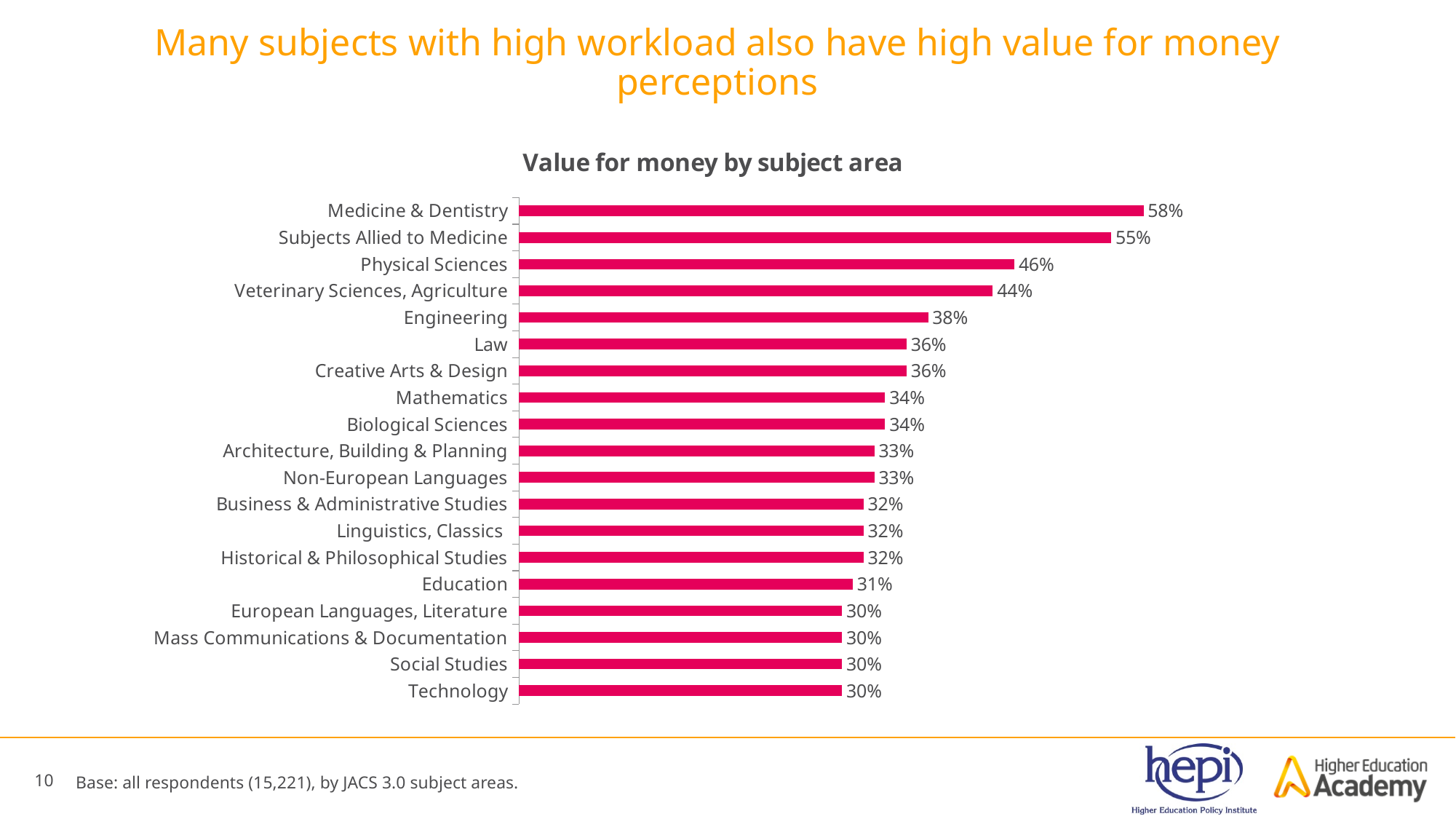
What is the title of the chart? Value for money by subject area How many subject areas are shown in the chart? 19 What is the value for money percentage for Engineering? 38% What kind of chart is shown on the slide? Bar chart What is the value for money percentage for Medicine & Dentistry? 58% Which has a higher value for money percentage, Law or Education? Law Which subject area has the highest value for money percentage? Medicine & Dentistry Which has a higher value for money percentage, Physical Sciences or Engineering? Physical Sciences What is the difference in percentage points between Medicine & Dentistry and Subjects Allied to Medicine? 3 What is the difference in percentage points between Physical Sciences and Technology? 16 What is the value for money percentage for Education? 31% What is the value for money percentage for Veterinary Sciences, Agriculture? 44%